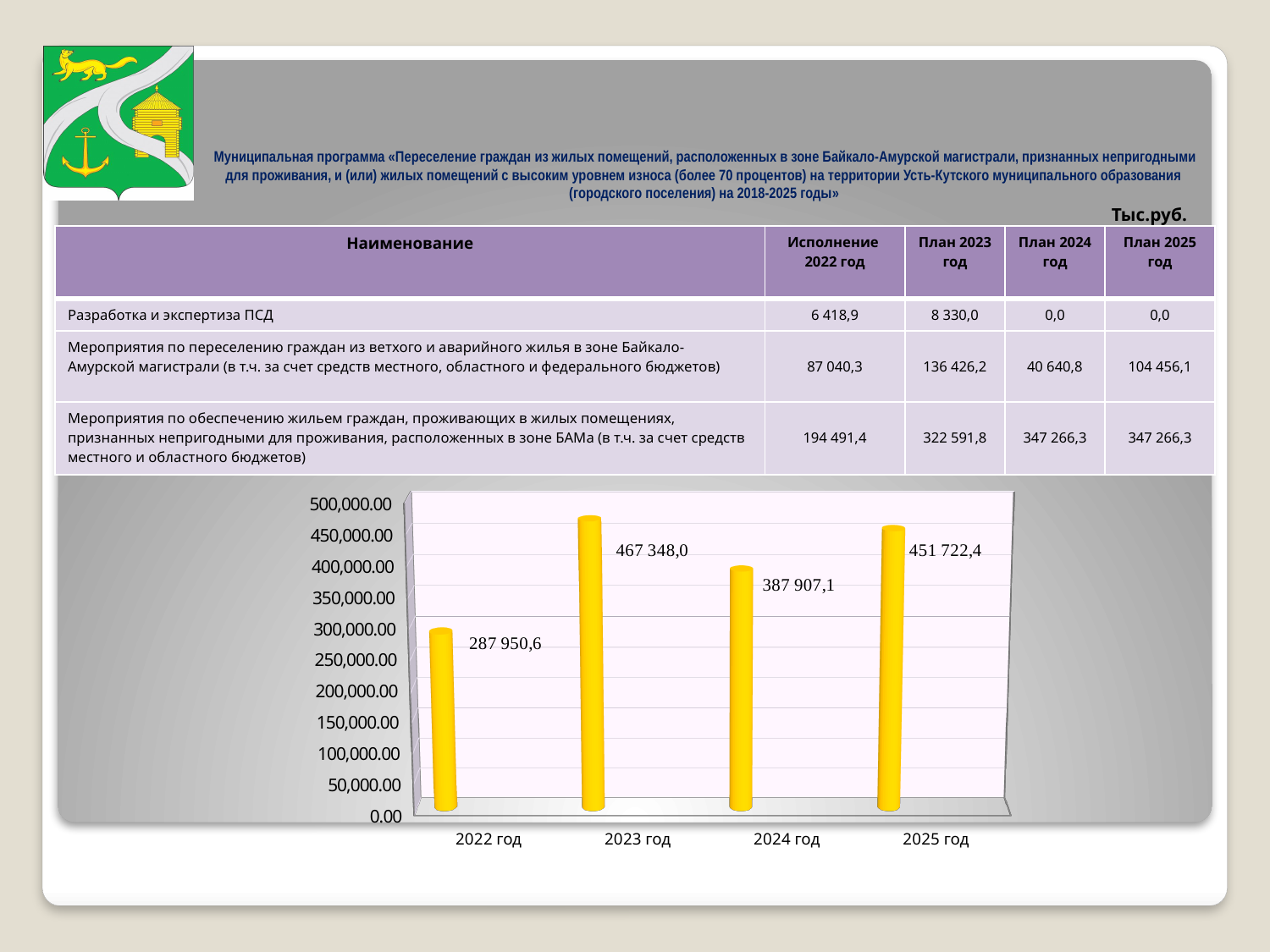
What is the value shown for 2025 год on the chart? 451 722,4 Which year has the lowest value on the chart? 2022 год What is the value shown for 2023 год on the chart? 467 348,0 What is the highest tick value on the vertical axis of the chart? 500,000.00 What is the value shown for 2024 год on the chart? 387 907,1 Which year has the highest value on the chart? 2023 год What kind of chart is shown on the slide? bar chart Is the value for 2022 год greater or less than 300,000.00? less How many years are shown on the x axis of the chart? 4 What is the difference between the values for 2023 год and 2022 год? 179 397,4 What is the value shown for 2022 год on the chart? 287 950,6 Which is larger, the value for 2024 год or the value for 2025 год? 2025 год